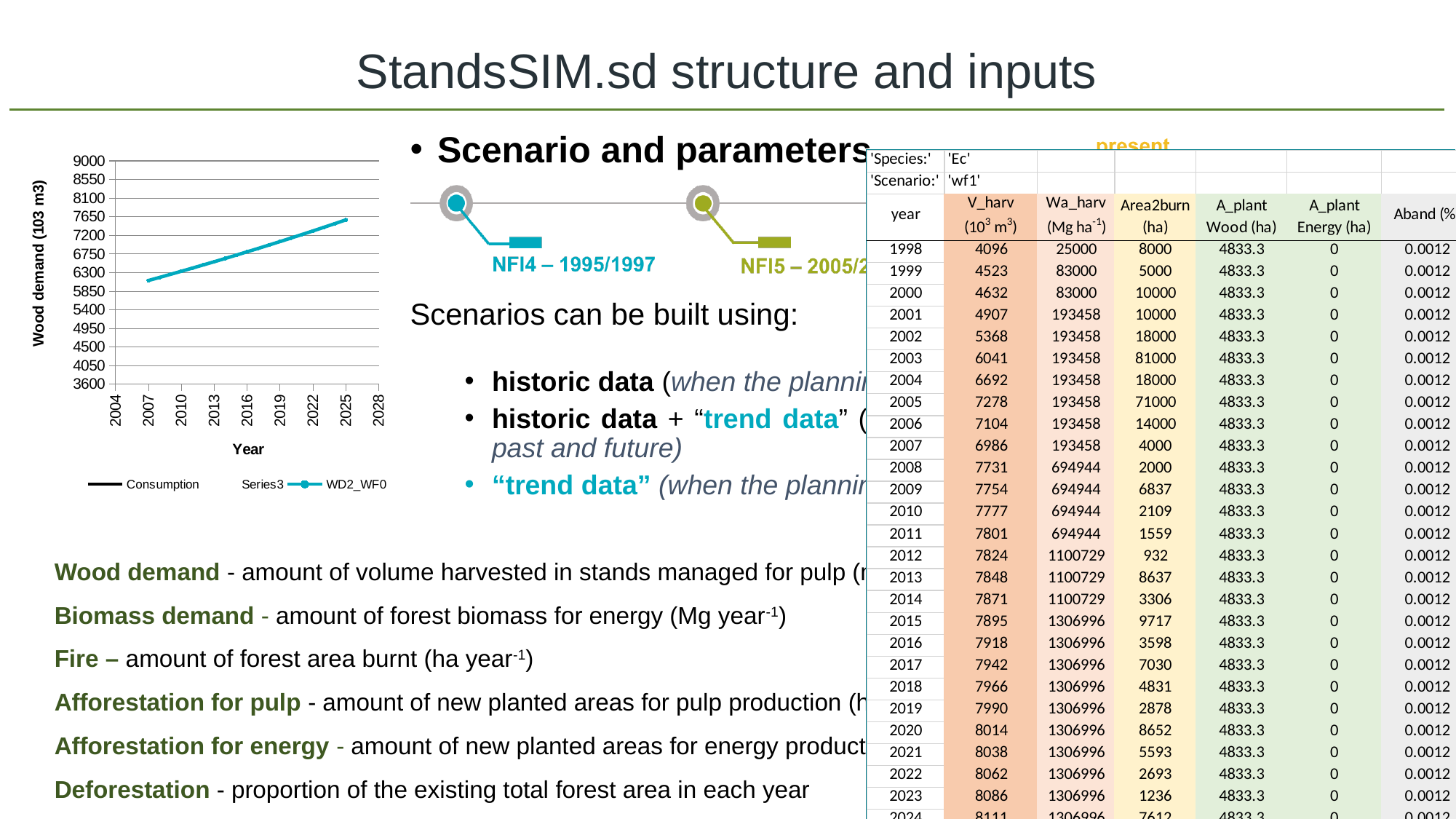
In the chart on the left, is the wood demand value at 2025 greater or less than 8100? less What is the title of the vertical axis of the chart on the left? Wood demand (103 m3) In the chart on the left, which year has the highest wood demand, 2007 or 2025? 2025 What is the title of the horizontal axis of the chart on the left? Year In the chart on the left, is the wood demand value at 2025 greater or less than 7200? greater How many series does the legend of the chart on the left list? 3 In the chart on the left, is the wood demand value at 2007 greater or less than 5850? greater What kind of chart is shown on the left of the slide? line chart In the chart on the left, does the wood demand line rise or fall as the year increases? rise